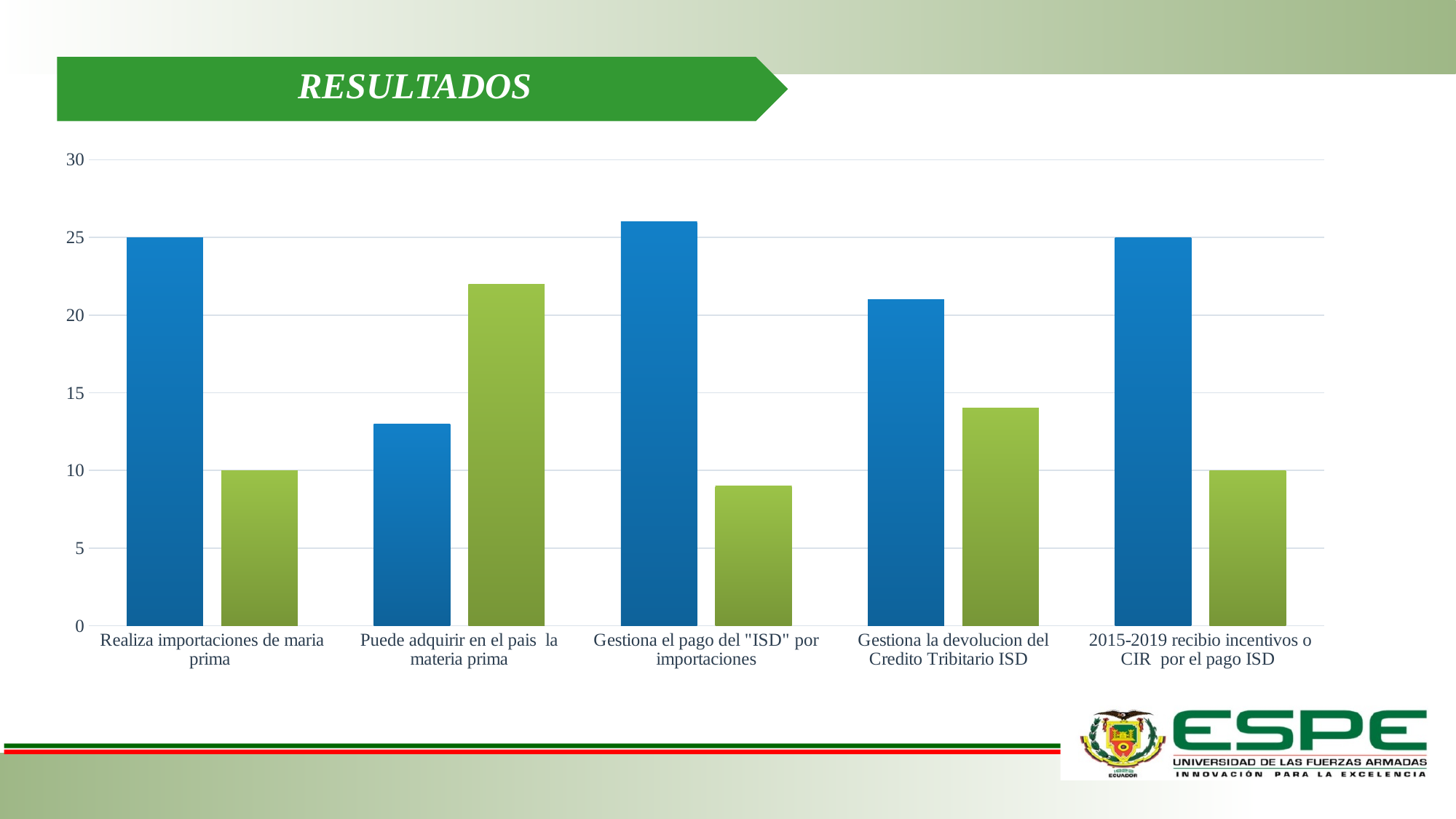
For "Realiza importaciones de maria prima", which bar is larger, the blue one or the green one? The blue one Which category has the highest green bar? Puede adquirir en el pais la materia prima What is the value of the green bar for "Realiza importaciones de maria prima"? 10 What kind of chart is shown on the slide? Bar chart What is the value of the blue bar for "2015-2019 recibio incentivos o CIR por el pago ISD"? 25 How many categories are shown on the x axis of the chart? 5 What is the value of the blue bar for "Realiza importaciones de maria prima"? 25 Which category has the lowest blue bar? Puede adquirir en el pais la materia prima What is the value of the green bar for "2015-2019 recibio incentivos o CIR por el pago ISD"? 10 Is the value of the blue bar for "Puede adquirir en el pais la materia prima" greater or less than 15? less What two colours are used for the bars in the chart? Blue and green Is the value of the green bar for "Gestiona el pago del "ISD" por importaciones" greater or less than 15? less